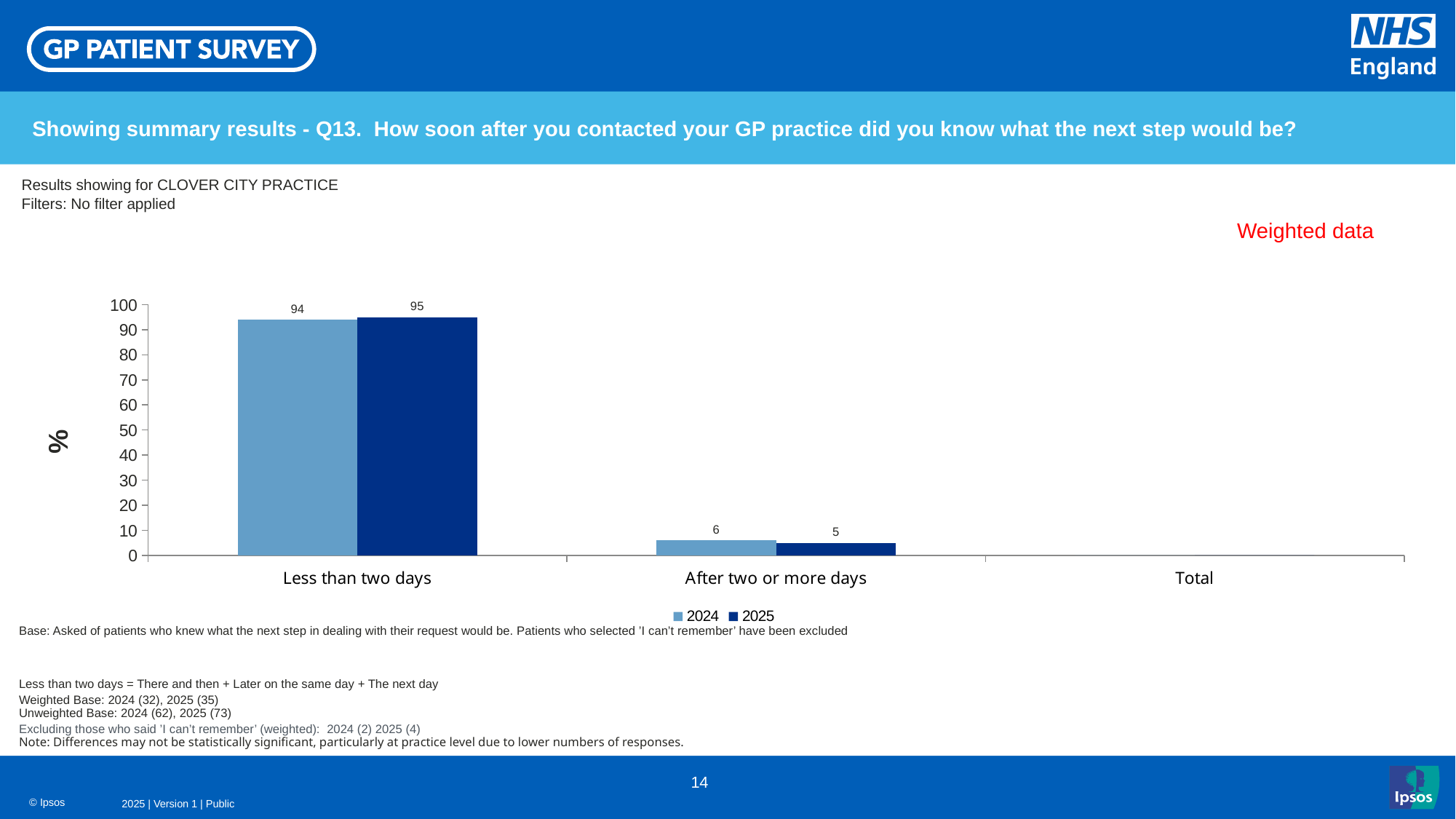
Which category has the highest value for the 2025 series? Less than two days Is the 2025 value for 'Less than two days' greater or less than 90? greater What is the 2025 value for 'Less than two days'? 95 What is the label on the vertical axis of the chart? % What is the 2025 value for 'After two or more days'? 5 What is the difference between the 2024 and 2025 values for 'Less than two days'? 1 What kind of chart is shown on the slide? Bar chart What is the 2024 value for 'After two or more days'? 6 How many series does the legend list? 2 Which category has the lowest value for the 2024 series? After two or more days What is the 2024 value for 'Less than two days'? 94 Which is larger for 'After two or more days': the 2024 value or the 2025 value? 2024